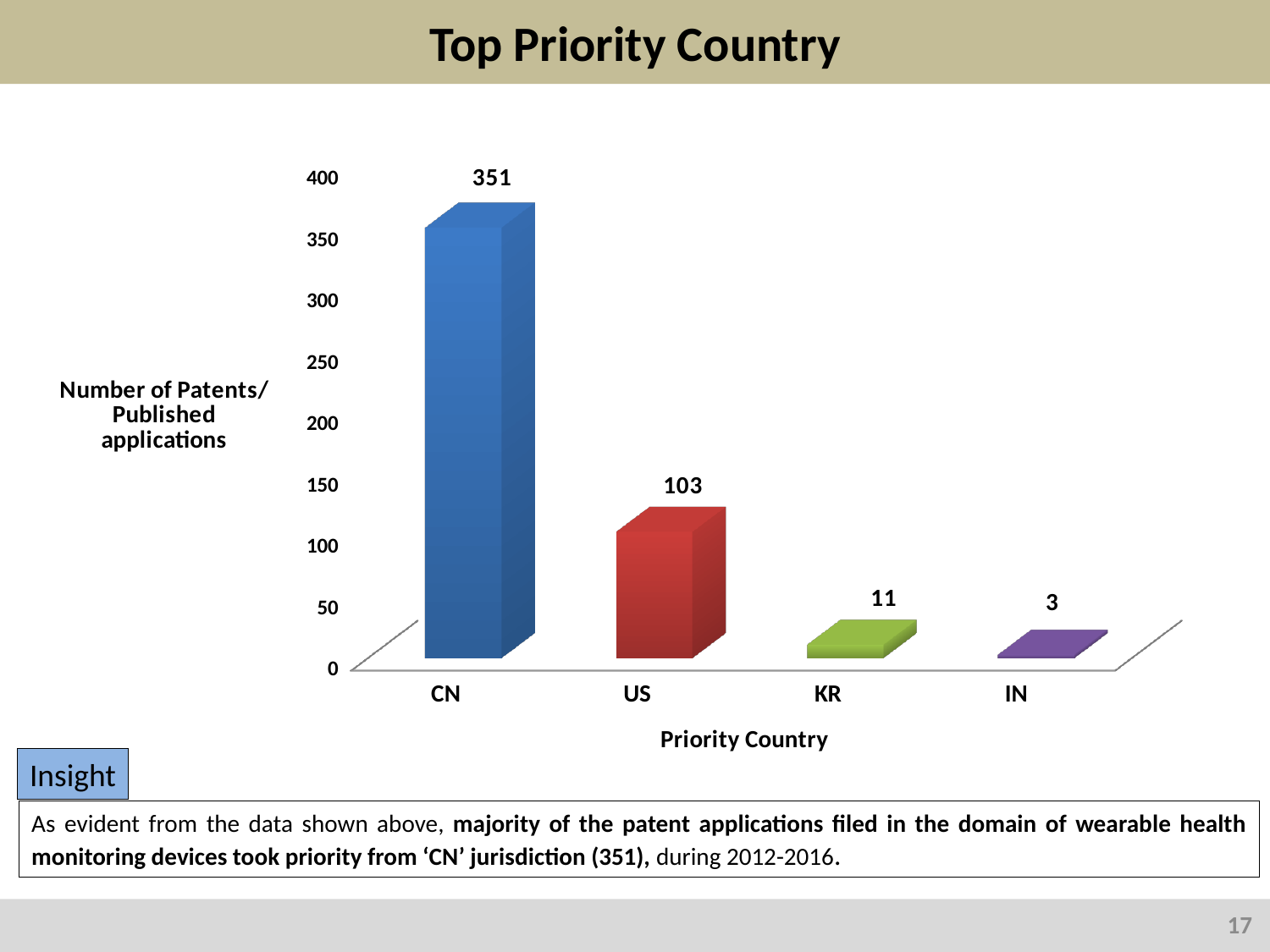
How many priority countries are shown on the chart? 4 What is the difference between the values for CN and US? 248 Which priority country has the highest number of patents/published applications? CN What is the number of patents/published applications for US? 103 What is the number of patents/published applications for IN? 3 What kind of chart is shown on the slide? Bar chart Which priority country has the lowest number of patents/published applications? IN What is the number of patents/published applications for CN? 351 What is the difference between the values for KR and IN? 8 Which has a larger value, US or KR? US What is the number of patents/published applications for KR? 11 What is the label of the x axis of the chart? Priority Country